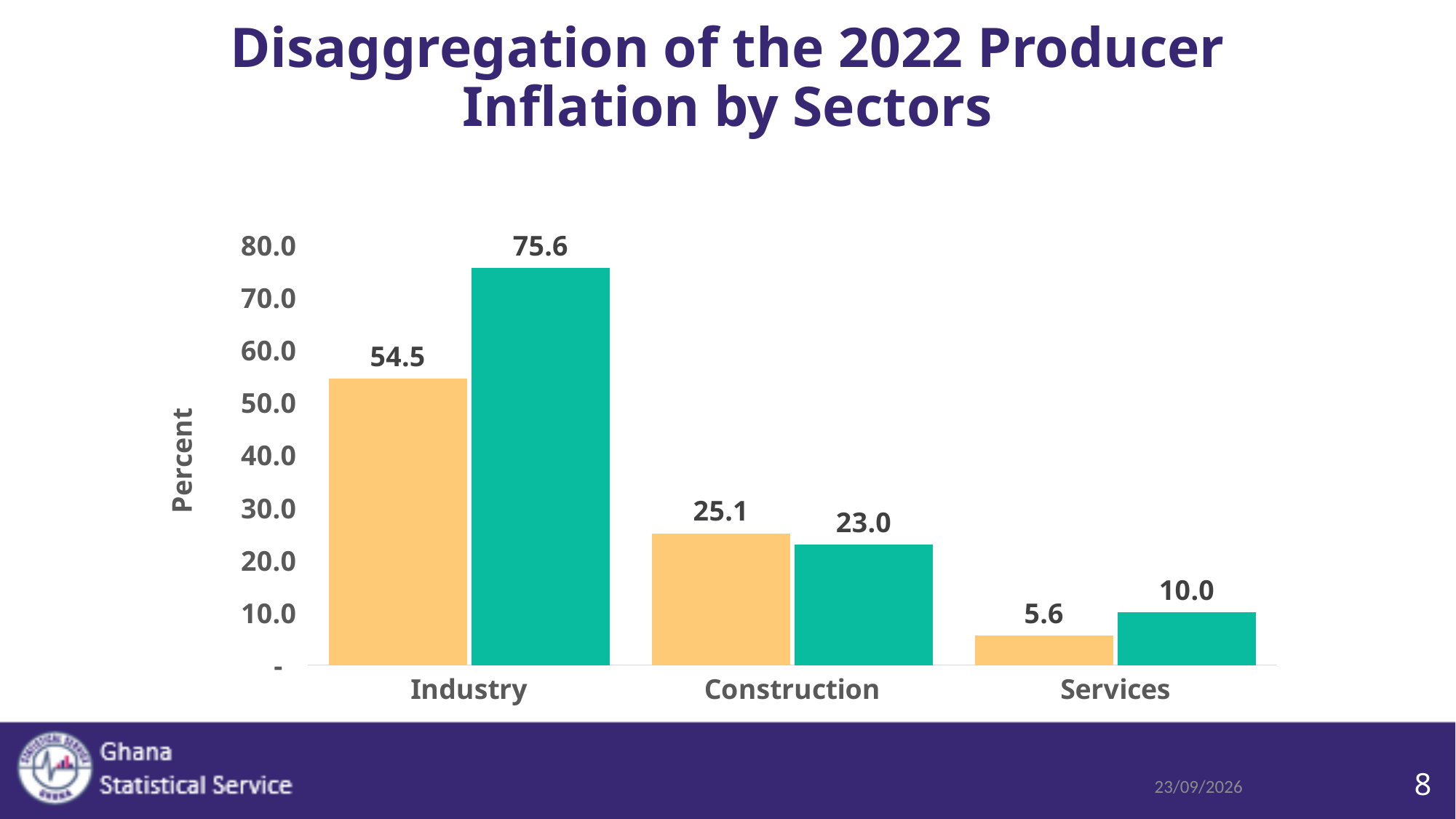
What is the value of the green bar for Services? 10.0 What is the difference between the green and orange bars for Industry? 21.1 Is the value of the orange bar for Services greater or less than 10.0? less What is the value of the orange bar for Industry? 54.5 Which sector has the highest green bar? Industry How many sectors are shown on the x axis? 3 What kind of chart is shown on the slide? bar chart What is the value of the green bar for Industry? 75.6 For Construction, which bar is larger, the orange or the green? orange What is the label on the vertical axis? Percent What is the value of the orange bar for Construction? 25.1 Which sector has the lowest orange bar? Services